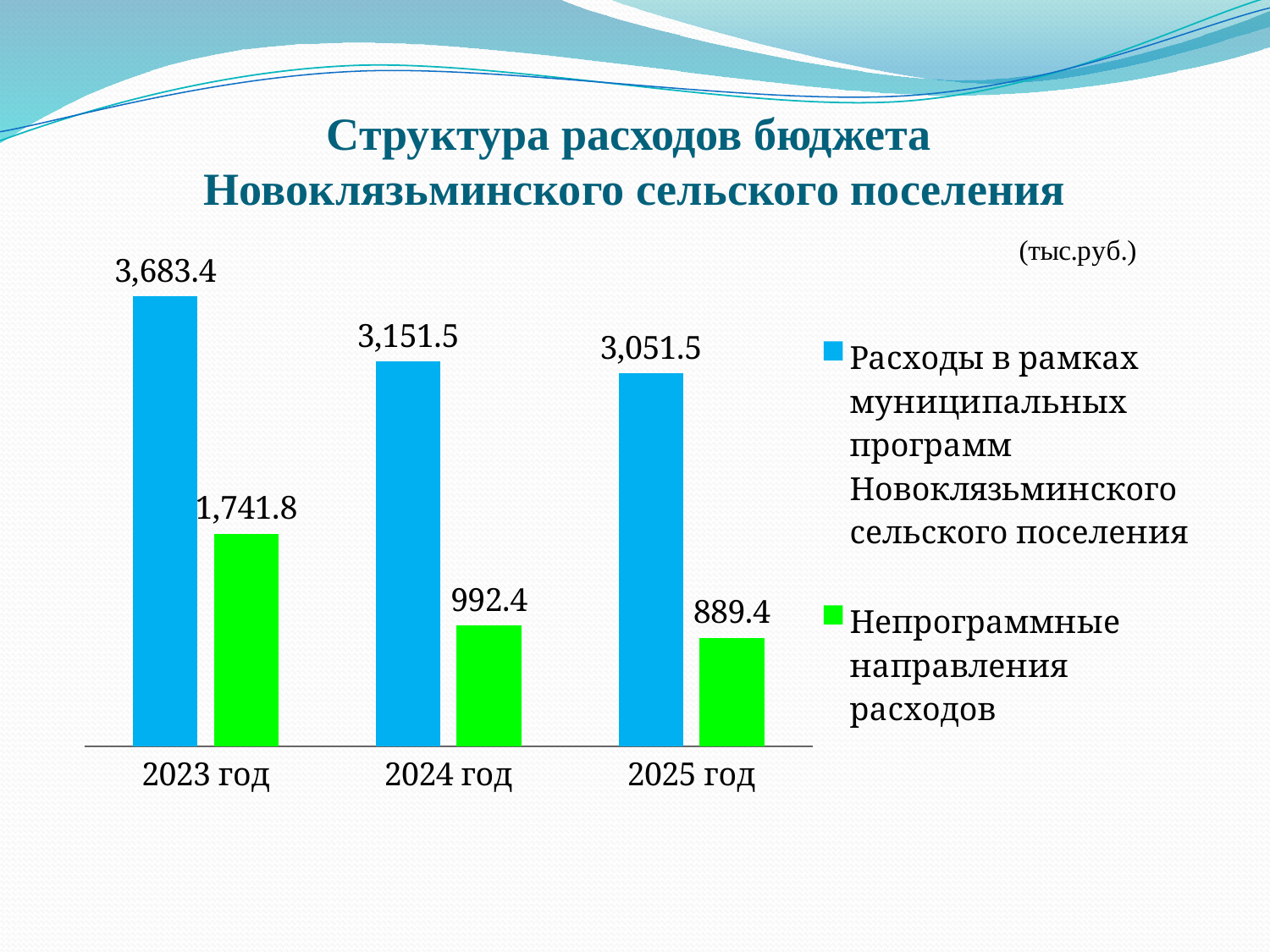
What is the value for 'Непрограммные направления расходов' in 2025 год? 889.4 Which is larger: 'Непрограммные направления расходов' in 2023 год or in 2025 год? 2023 год What is the difference between the 'Расходы в рамках муниципальных программ' values for 2024 год and 2025 год? 100.0 What kind of chart is shown on the slide? Bar chart How many years are shown on the x axis? 3 In which year is the value for 'Расходы в рамках муниципальных программ Новоклязьминского сельского поселения' highest? 2023 год What is the value for 'Расходы в рамках муниципальных программ Новоклязьминского сельского поселения' in 2025 год? 3,051.5 What is the value for 'Непрограммные направления расходов' in 2024 год? 992.4 In which year is the value for 'Непрограммные направления расходов' lowest? 2025 год How many series does the legend list? 2 What is the difference between the 'Непрограммные направления расходов' values for 2023 год and 2024 год? 749.4 What is the value for 'Расходы в рамках муниципальных программ Новоклязьминского сельского поселения' in 2023 год? 3,683.4